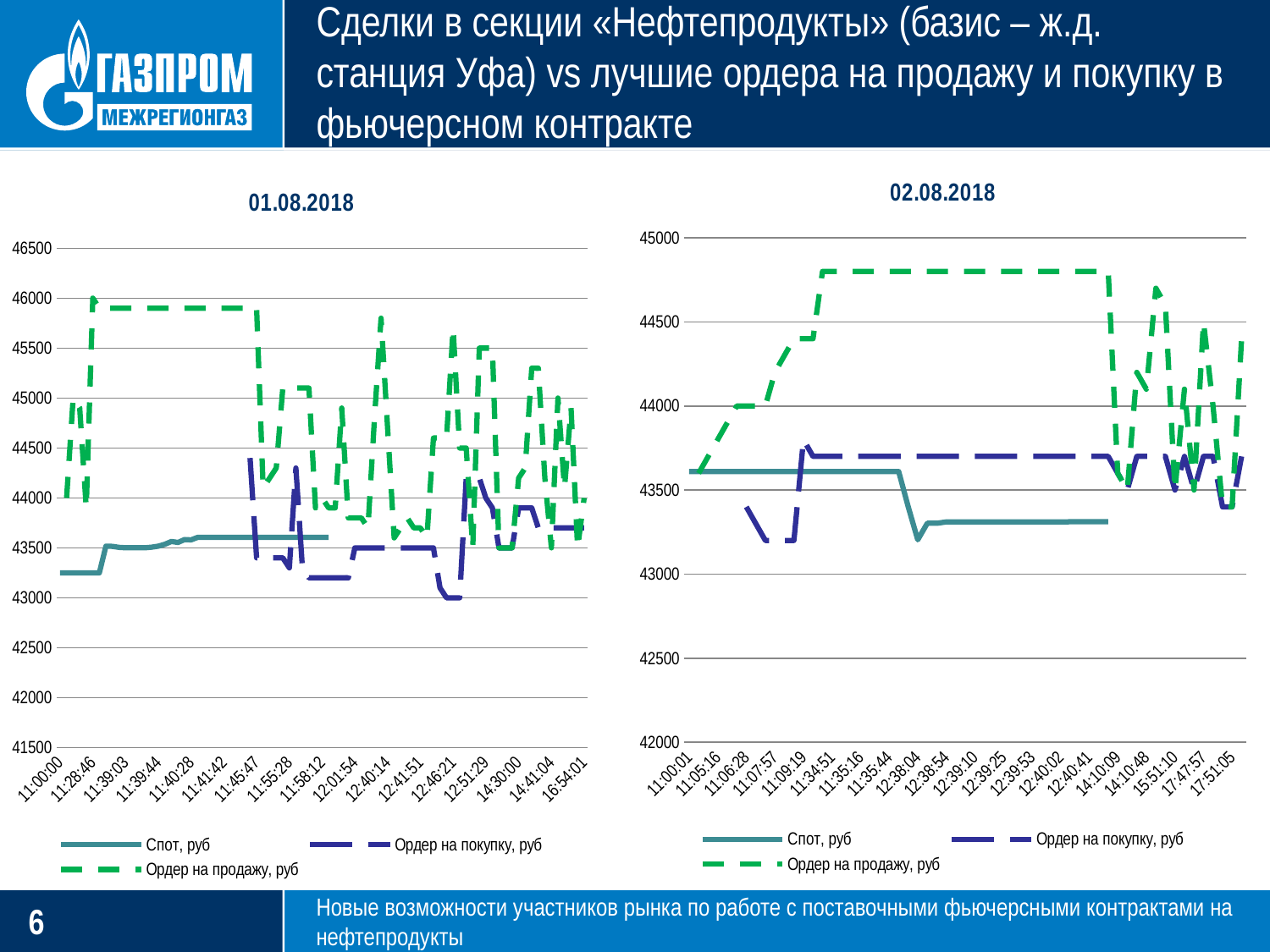
How many series does the legend of the chart titled 02.08.2018 list? 3 What is the highest value shown on the vertical axis of the chart titled 02.08.2018? 45000 In the chart titled 01.08.2018, is the value of Ордер на покупку, руб around 11:58:12 greater or less than 43500? less In the chart titled 02.08.2018, is the value of Ордер на покупку, руб at 11:06:28 greater or less than 43500? less In the chart titled 02.08.2018, is the value of Спот, руб after 12:38:54 greater or less than 43500? less In the chart titled 01.08.2018, which series is shown with a green dashed line? Ордер на продажу, руб In the chart titled 02.08.2018, does the Спот, руб line overall rise or fall from its first point to its last point? fall What kind of chart is the chart titled 01.08.2018? line chart In the chart titled 01.08.2018, at 11:28:46, which is larger: Ордер на продажу, руб or Спот, руб? Ордер на продажу, руб